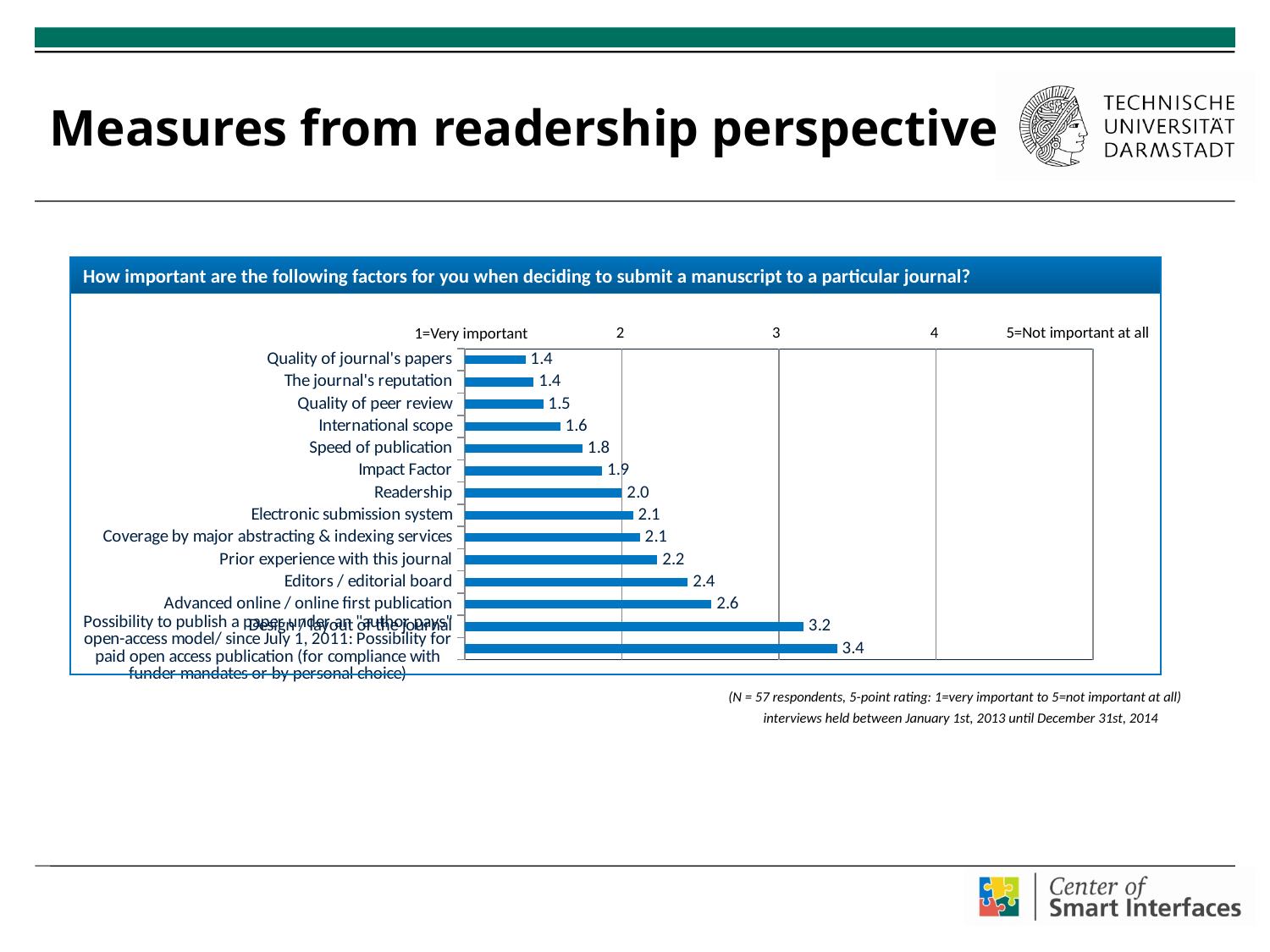
What is the value for Speed of publication? 1.8 Is the value for Advanced online / online first publication greater or less than 2? greater What does the label at the right end of the rating scale say? 5=Not important at all What is the difference between the values for Editors / editorial board and Quality of peer review? 0.9 What is the value for Readership? 2.0 What is the value for Editors / editorial board? 2.4 What kind of chart is shown on the slide? bar chart What is the value for Impact Factor? 1.9 What is the difference between the values for Advanced online / online first publication and Speed of publication? 0.8 Which has the larger value, Prior experience with this journal or International scope? Prior experience with this journal What is the value for Advanced online / online first publication? 2.6 How many bars are plotted in the chart? 14